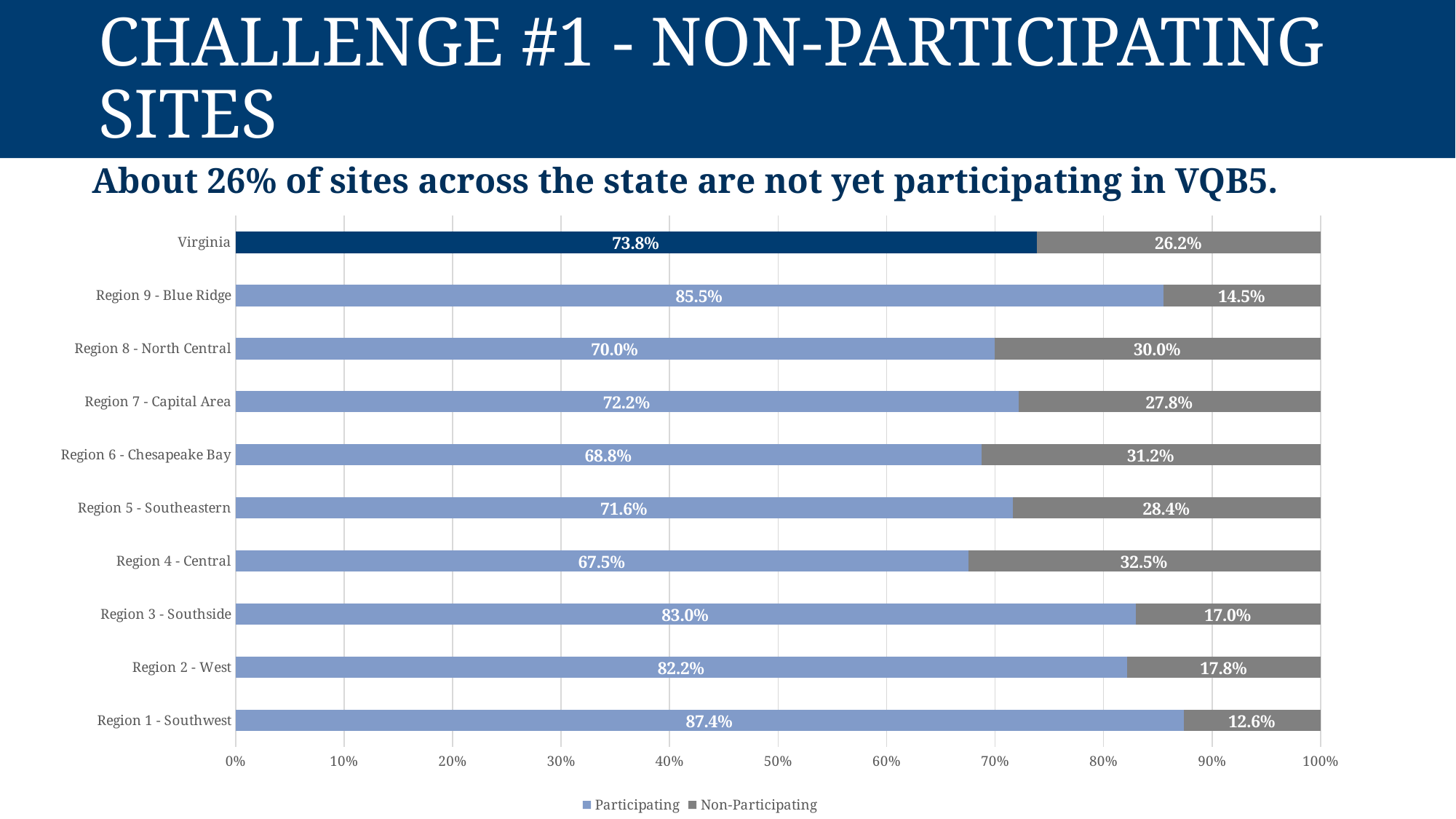
What are the two series listed in the legend? Participating and Non-Participating What is the Participating value for Virginia? 73.8% How many series does the legend list? 2 What is the difference between the Non-Participating values for Region 8 - North Central and Region 9 - Blue Ridge? 15.5% What is the Participating value for Region 9 - Blue Ridge? 85.5% What is the Non-Participating value for Region 4 - Central? 32.5% Which region has the highest Participating value? Region 1 - Southwest What kind of chart is shown on the slide? Stacked bar chart Which region has the lowest Participating value? Region 4 - Central What is the total of the stacked bar for Region 6 - Chesapeake Bay? 100.0% Which has a larger Participating value, Region 3 - Southside or Region 2 - West? Region 3 - Southside How many categories (bars) are shown on the chart? 10